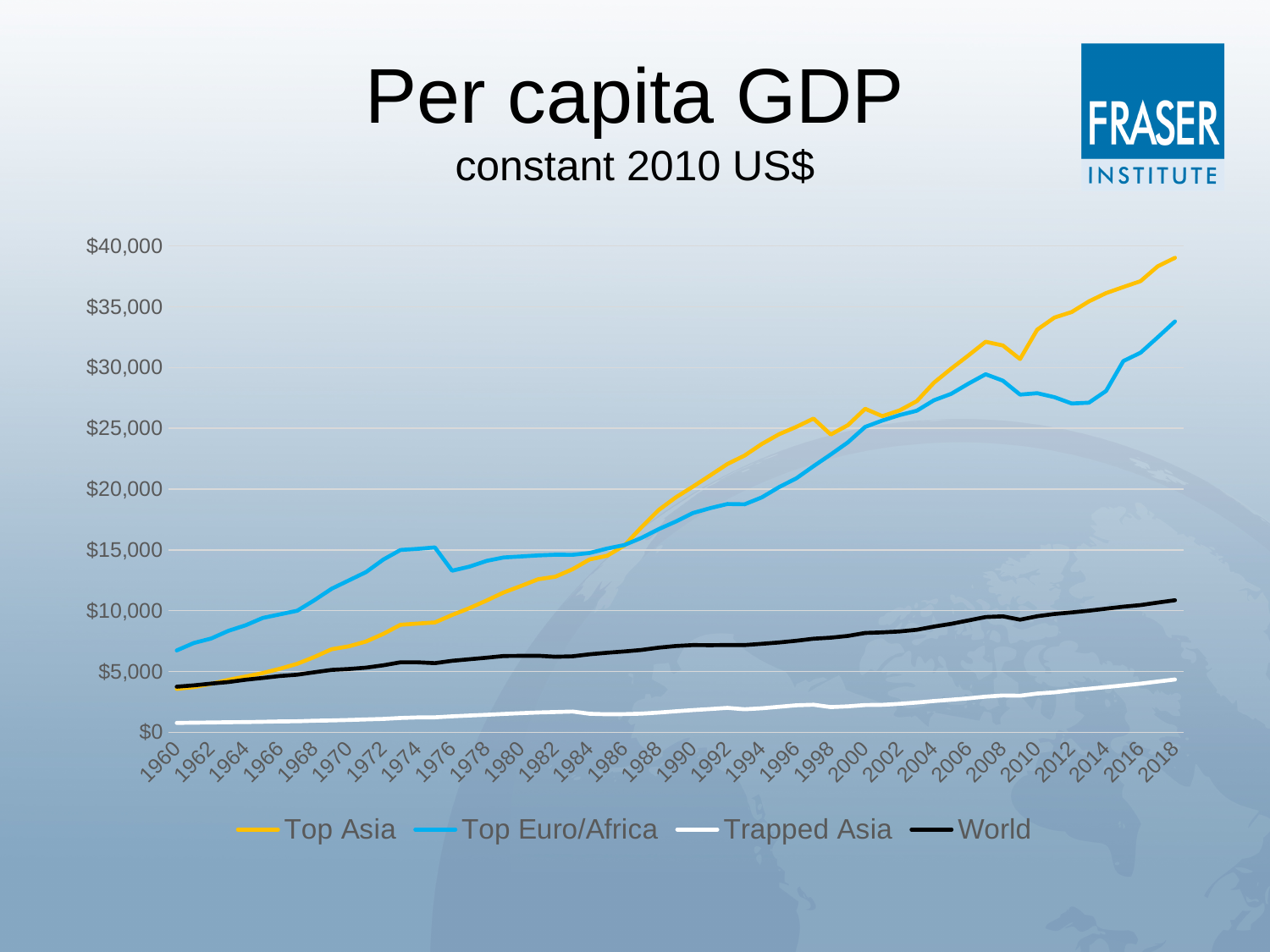
Which series has the lowest values across the whole period? Trapped Asia What kind of chart is shown on the slide? Line chart Is the value for Top Euro/Africa in 2018 greater or less than $35,000? less Which series has the highest value in 2018? Top Asia In 1960, which is larger: Top Asia or Top Euro/Africa? Top Euro/Africa How many series does the legend list? 4 In 2018, which is larger: Top Asia or Top Euro/Africa? Top Asia Is the value for Top Euro/Africa in 1960 greater or less than $5,000? greater Is the value for Top Asia in 2018 greater or less than $35,000? greater Does the Top Asia series generally rise or fall from 1960 to 2018? Rise What is the title of the chart? Per capita GDP